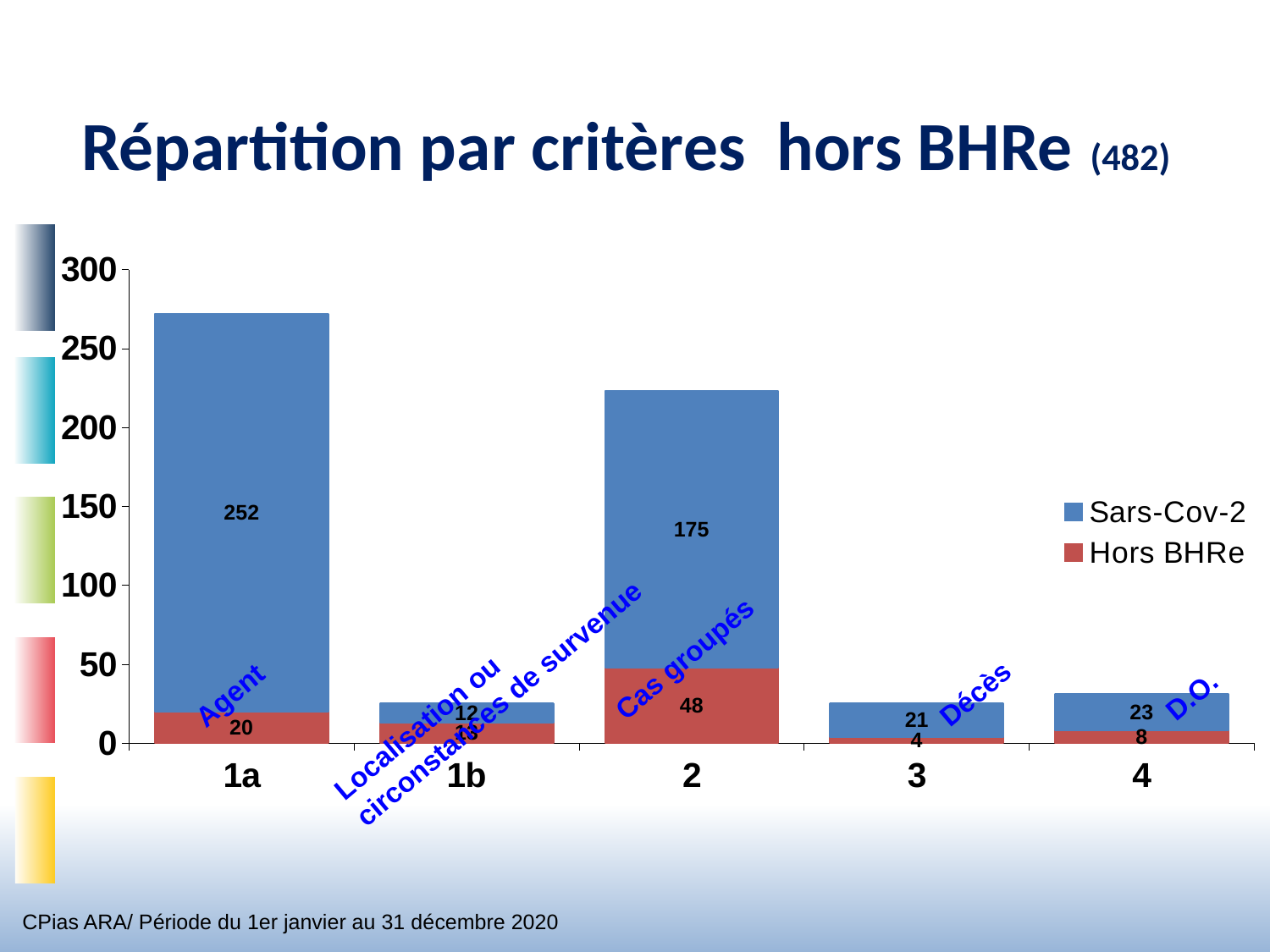
What type of chart is shown on the slide? bar chart How many series does the legend list? 2 Which series is shown in blue in the legend? Sars-Cov-2 What is the Sars-Cov-2 value for category 4? 23 Which category has the highest Sars-Cov-2 value? 1a What is the Sars-Cov-2 value for category 1a? 252 What is the Hors BHRe value for category 2? 48 How many categories are shown on the x axis? 5 What is the total of the stacked bar for category 2? 223 What is the difference between the Sars-Cov-2 values for categories 1a and 2? 77 What is the Hors BHRe value for category 3? 4 Which category has the lowest Hors BHRe value? 3